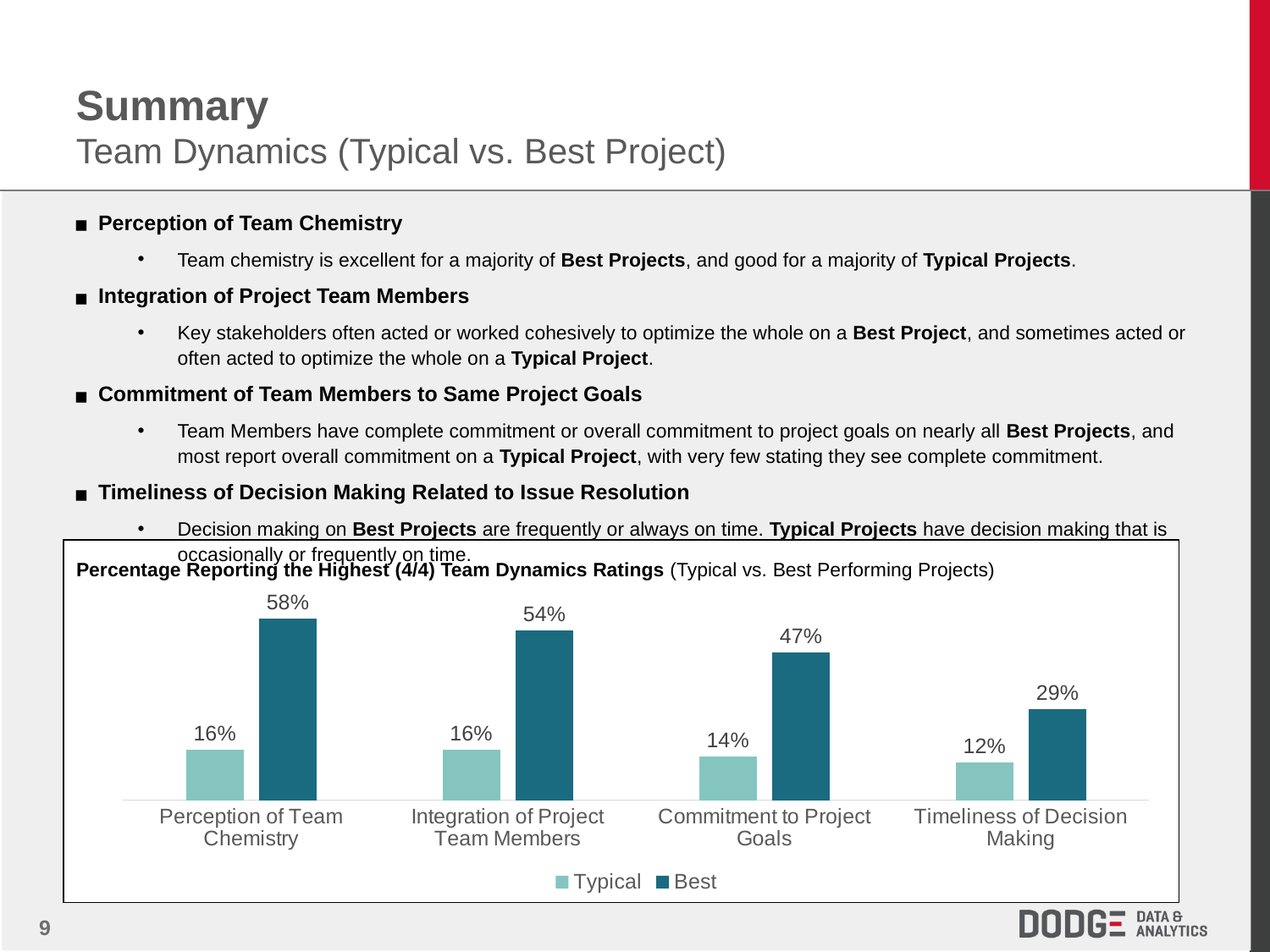
Which category has the lowest Typical value? Timeliness of Decision Making How many categories are shown on the x axis? 4 What is the Typical value for Timeliness of Decision Making? 12% Which is larger: the Best value for Timeliness of Decision Making or the Best value for Commitment to Project Goals? Commitment to Project Goals How many series does the legend list? 2 Which category has the highest Best value? Perception of Team Chemistry What is the Typical value for Commitment to Project Goals? 14% Do the Best values rise or fall from left to right across the categories? Fall What is the Best value for Perception of Team Chemistry? 58% What are the two series named in the legend? Typical and Best What kind of chart is shown? Bar chart What is the difference between the Best and Typical values for Integration of Project Team Members? 38%